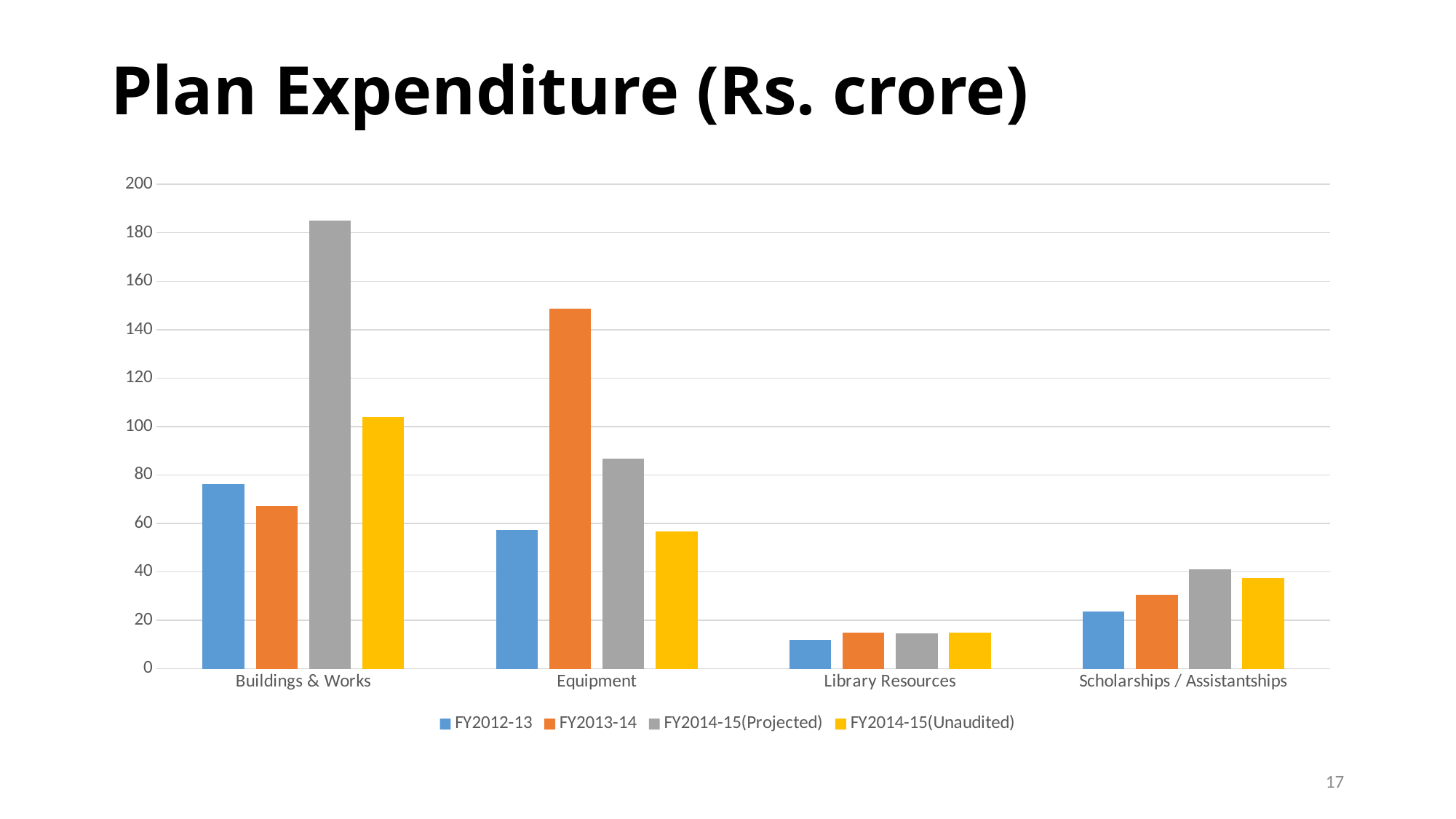
Is the FY2013-14 value for Equipment greater or less than 140? greater Is the FY2014-15(Projected) value for Buildings & Works greater or less than 180? greater What colour represents the FY2014-15(Unaudited) series? yellow Which series has the highest value for Equipment? FY2013-14 For Scholarships / Assistantships, which is larger: FY2012-13 or FY2014-15(Projected)? FY2014-15(Projected) Which series has the highest value for Buildings & Works? FY2014-15(Projected) Which category has the tallest bar overall? Buildings & Works How many categories are shown on the x axis? 4 How many series does the legend list? 4 What kind of chart is shown on the slide? bar chart Is the FY2012-13 value for Library Resources greater or less than 20? less Which category has the lowest values across all series? Library Resources